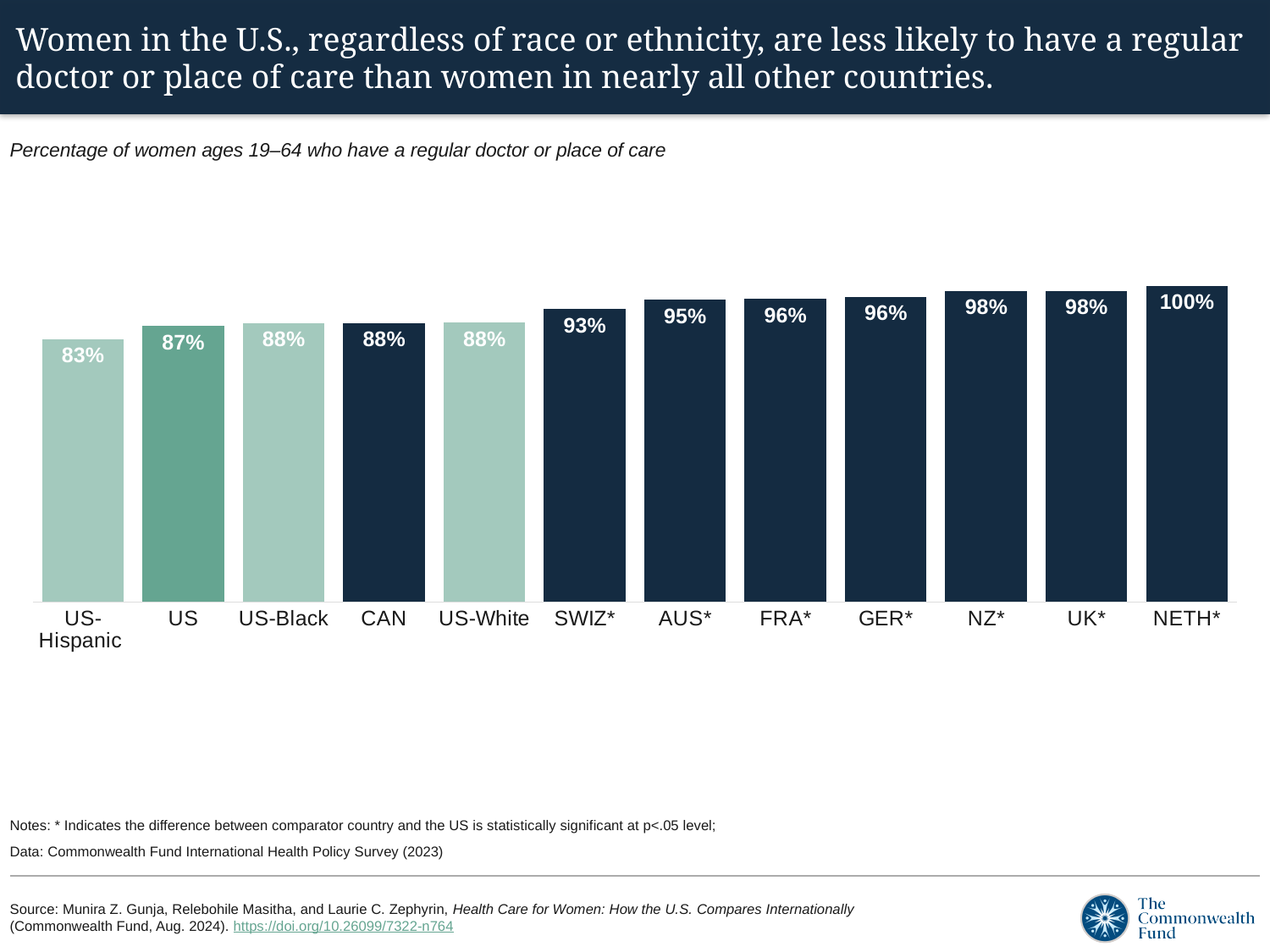
What is the value shown for NETH*? 100% What is the difference between the values for AUS* and US? 8 percentage points Which category has the highest percentage of women with a regular doctor or place of care? NETH* What does the asterisk (*) after a country name indicate, according to the notes? The difference between comparator country and the US is statistically significant at p<.05 level What kind of chart is shown on the slide? Bar chart Which category has the lowest percentage of women with a regular doctor or place of care? US-Hispanic What is the value shown for SWIZ*? 93% How many categories are shown on the x axis of the chart? 12 What percentage of US-Hispanic women ages 19–64 have a regular doctor or place of care? 83% Which is larger, the value for US or the value for CAN? CAN What is the difference between the values for NETH* and US-Hispanic? 17 percentage points Do the values generally rise or fall moving from left to right along the x axis? Rise